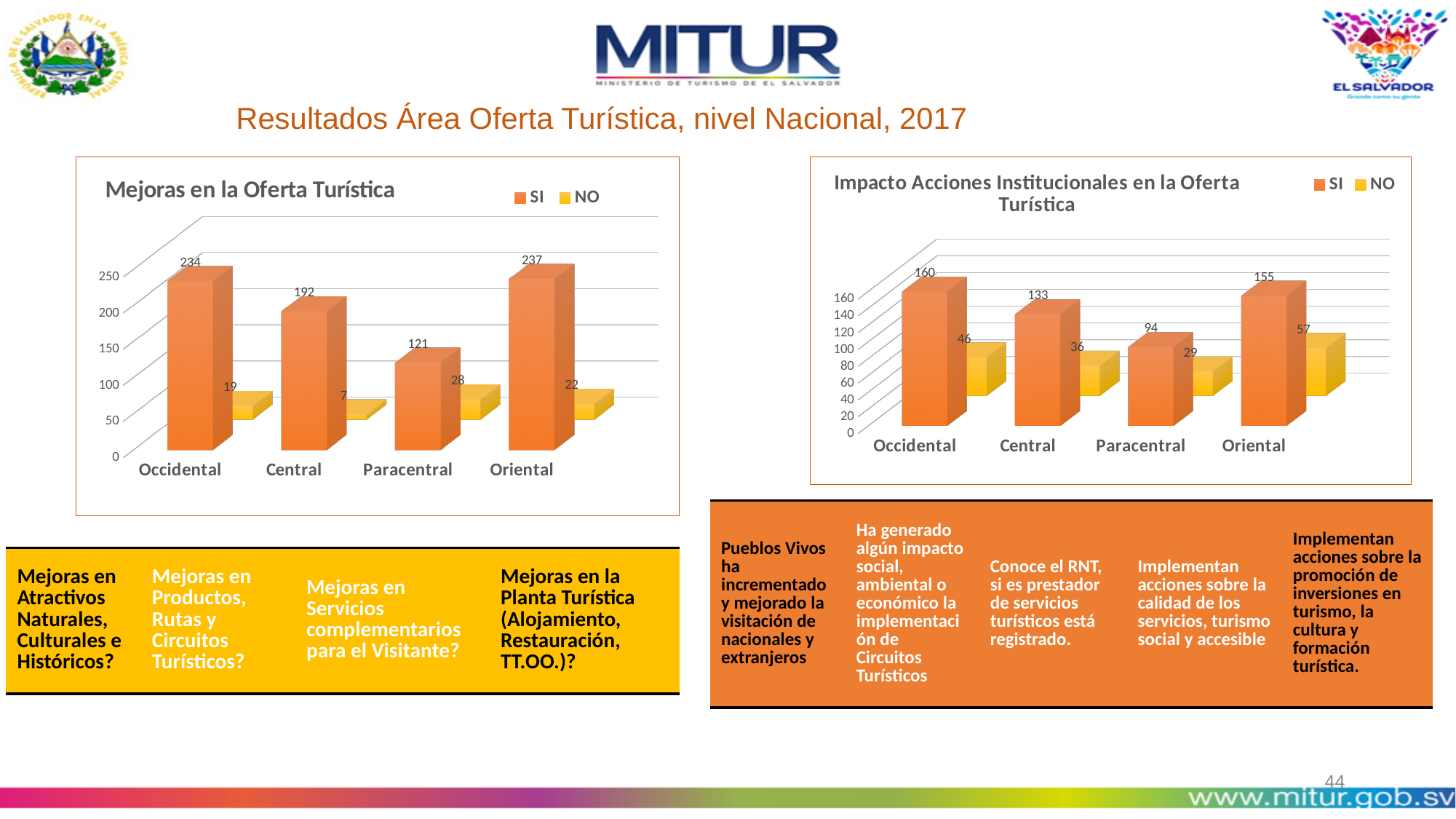
In the 'Mejoras en la Oferta Turística' chart, which region has the highest SI value? Oriental How many series does the legend of the 'Mejoras en la Oferta Turística' chart list? 2 In the 'Impacto Acciones Institucionales en la Oferta Turística' chart, which region has the highest NO value? Oriental In the 'Impacto Acciones Institucionales en la Oferta Turística' chart, what is the SI value for Central? 133 In the 'Mejoras en la Oferta Turística' chart, what is the NO value for Central? 7 In the 'Impacto Acciones Institucionales en la Oferta Turística' chart, which region has the lowest SI value? Paracentral In the 'Impacto Acciones Institucionales en la Oferta Turística' chart, what is the NO value for Oriental? 57 In the 'Impacto Acciones Institucionales en la Oferta Turística' chart, is the SI value for Occidental or Oriental larger? Occidental In the 'Mejoras en la Oferta Turística' chart, what is the SI value for Occidental? 234 What kind of chart is the 'Impacto Acciones Institucionales en la Oferta Turística' chart? Bar chart In the 'Mejoras en la Oferta Turística' chart, which region has the lowest SI value? Paracentral In the 'Mejoras en la Oferta Turística' chart, what is the difference between the SI values for Oriental and Paracentral? 116